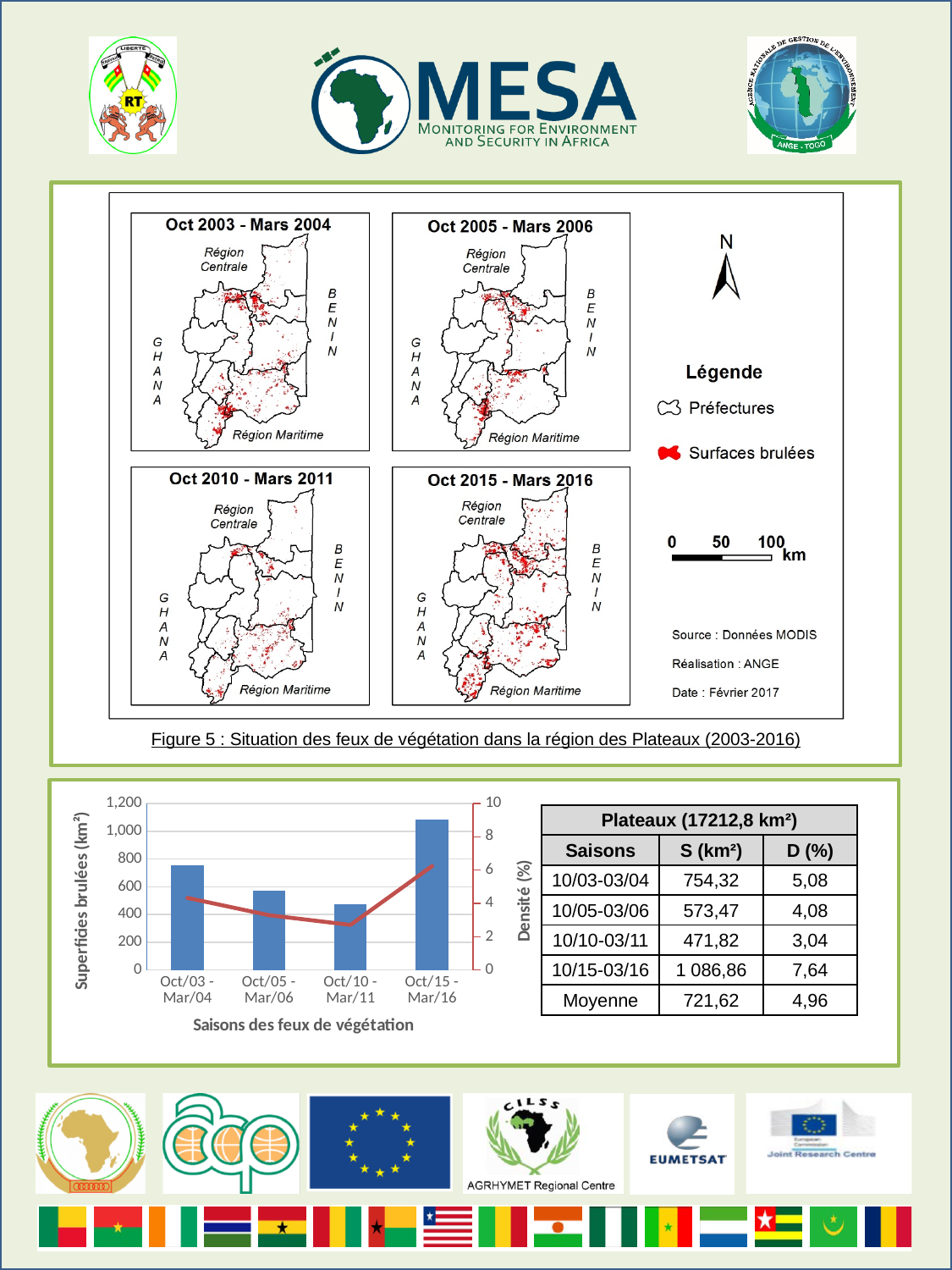
From Oct/03 - Mar/04 to Oct/10 - Mar/11, do the bars rise or fall? fall What is the title of the x axis of the chart? Saisons des feux de végétation What kind of chart is shown at the bottom of the slide? A bar chart with a line overlaid Which bar is taller, Oct/03 - Mar/04 or Oct/05 - Mar/06? Oct/03 - Mar/04 Is the bar for Oct/10 - Mar/11 greater or less than 600? less Is the bar for Oct/03 - Mar/04 greater or less than 600? greater Is the bar for Oct/15 - Mar/16 greater or less than 1,000? greater Which season has the shortest bar in the chart? Oct/10 - Mar/11 Which season has the tallest bar in the chart? Oct/15 - Mar/16 How many fire seasons are shown on the x axis of the chart? 4